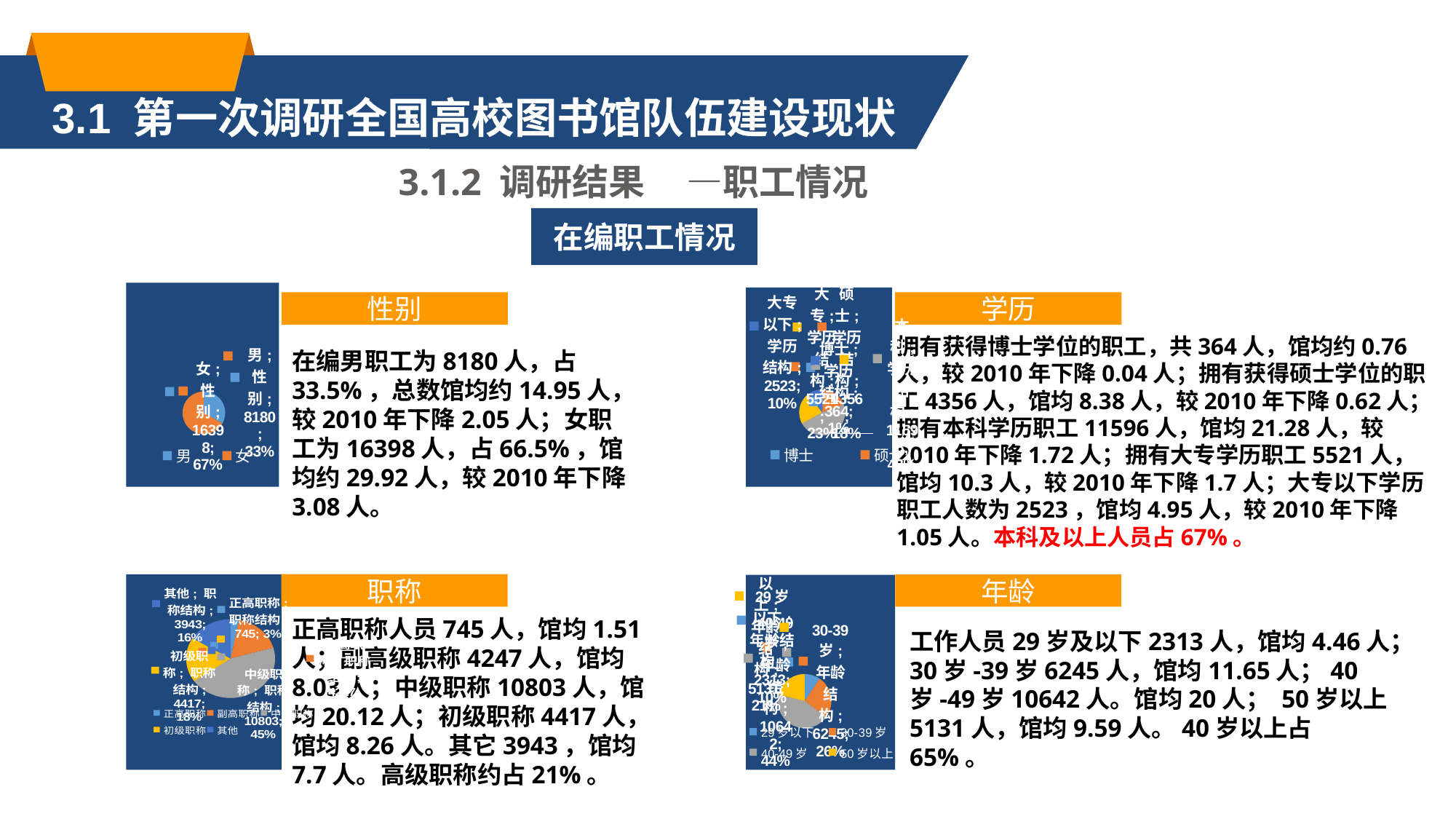
In the 性别 (gender) pie chart, what value is shown for 男? 8180; 33% In the 年龄 (age) pie chart, what percentage share is shown for 40-49岁? 44% In the 性别 (gender) pie chart, which slice is larger, 男 or 女? 女 In the 职称 (professional title) pie chart, what value is shown for 中级职称? 10803; 45% How many pie charts are shown on the slide? 4 In the 职称 (professional title) pie chart, what is the difference between the counts for 初级职称 (4417) and 其他 (3943)? 474 In the 职称 (professional title) pie chart, what value is shown for 正高职称? 745; 3% How many entries does the legend of the 性别 (gender) pie chart list? 2 In the 性别 (gender) pie chart, what percentage share is shown for 女? 67% In the 职称 (professional title) pie chart, which category has the smallest slice? 正高职称 In the 职称 (professional title) pie chart, which category has the largest slice? 中级职称 What kind of chart is the 性别 (gender) chart on the left of the slide? pie chart